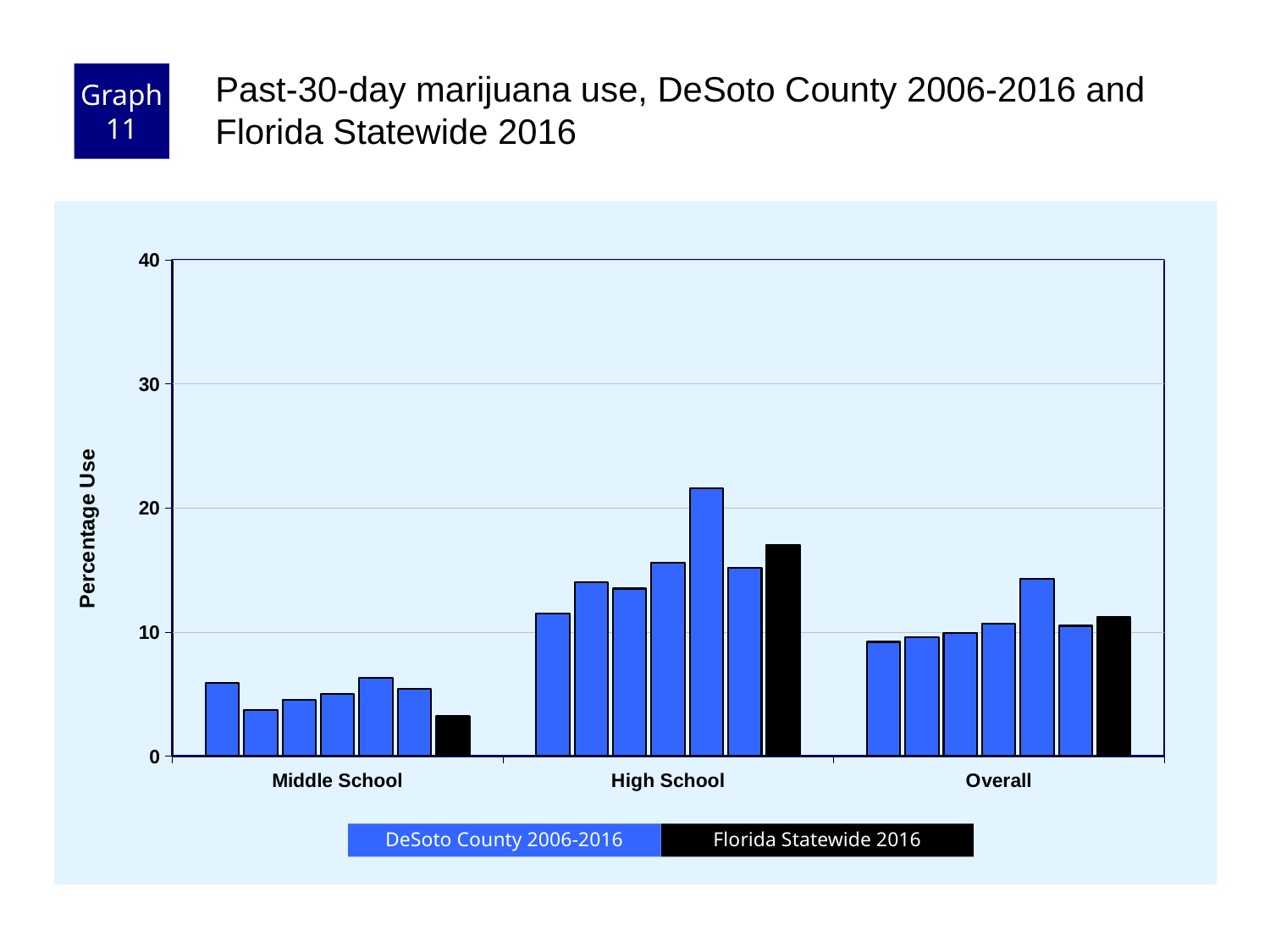
Which category has the lowest bars overall? Middle School How many series does the legend list? 2 How many categories are shown on the x axis? 3 Is the Florida Statewide 2016 value for Middle School greater or less than 10? less Are all the Middle School bars greater or less than 10? less What is the label on the y axis? Percentage Use Which is larger, the Florida Statewide 2016 value for High School or for Middle School? High School Is the tallest DeSoto County bar in the High School group greater or less than 20? greater What kind of chart is shown on the slide? bar chart Which category has the highest bars overall? High School